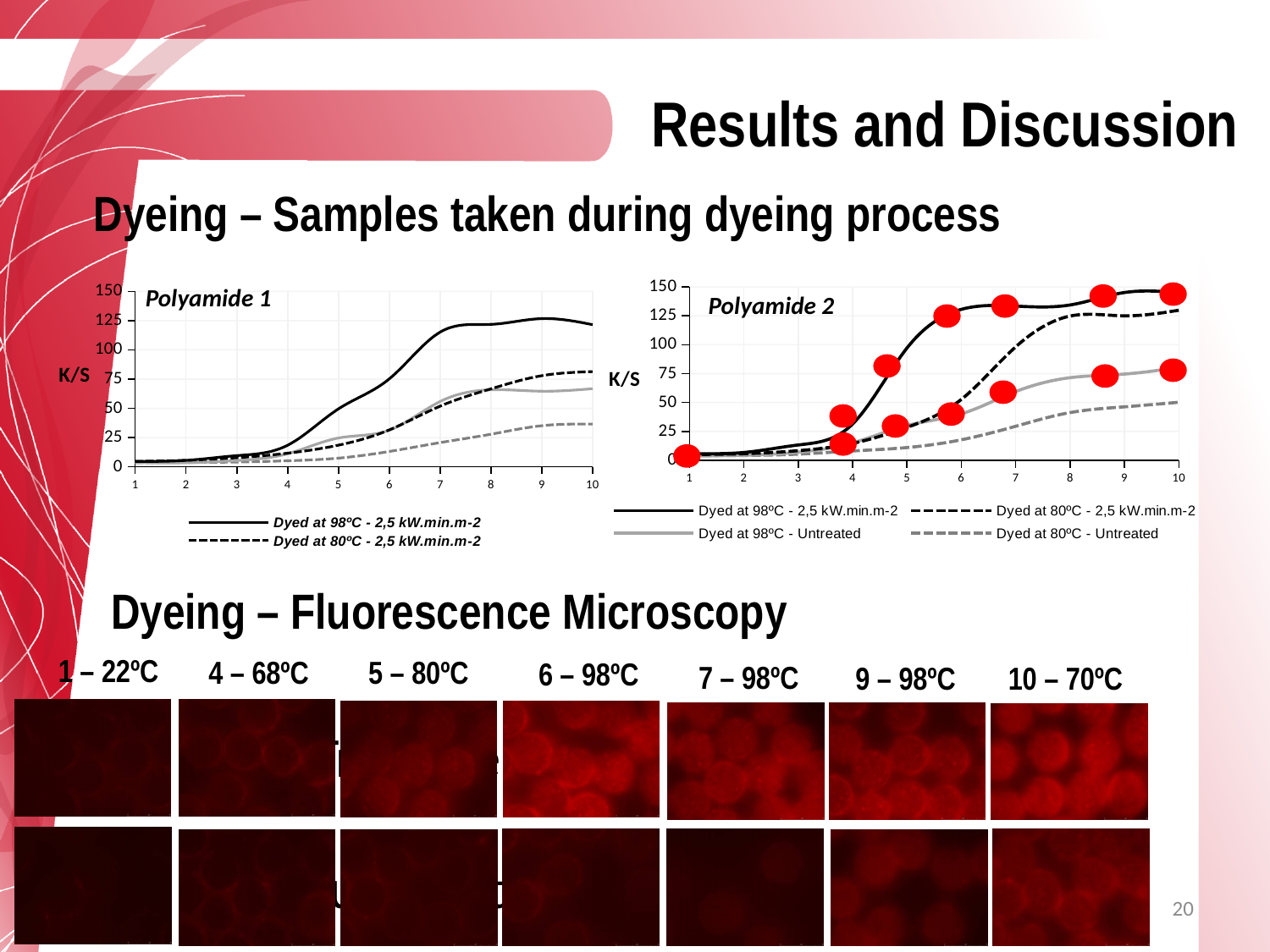
In the Polyamide 2 chart, is the value of the 'Dyed at 98ºC - Untreated' series at sample 10 greater or less than 50? greater What kind of chart is the Polyamide 1 chart? line chart In the Polyamide 2 chart, at sample 10, which is larger: 'Dyed at 98ºC - 2,5 kW.min.m-2' or 'Dyed at 98ºC - Untreated'? Dyed at 98ºC - 2,5 kW.min.m-2 In the Polyamide 2 chart, which series has the highest value at sample 10? Dyed at 98ºC - 2,5 kW.min.m-2 How many series does the legend of the Polyamide 2 chart list? 4 In the Polyamide 2 chart, is the value of the 'Dyed at 80ºC - 2,5 kW.min.m-2' series at sample 10 greater or less than 100? greater In the Polyamide 1 chart, is the value of the 'Dyed at 98ºC - 2,5 kW.min.m-2' series at sample 10 greater or less than 100? greater How many sample points are marked along the x axis of the Polyamide 2 chart? 10 In the Polyamide 1 chart, do the values of the 'Dyed at 98ºC - 2,5 kW.min.m-2' series generally rise or fall from sample 1 to sample 10? rise In the Polyamide 2 chart, which series has the lowest value at sample 10? Dyed at 80ºC - Untreated How many series does the legend of the Polyamide 1 chart list? 2